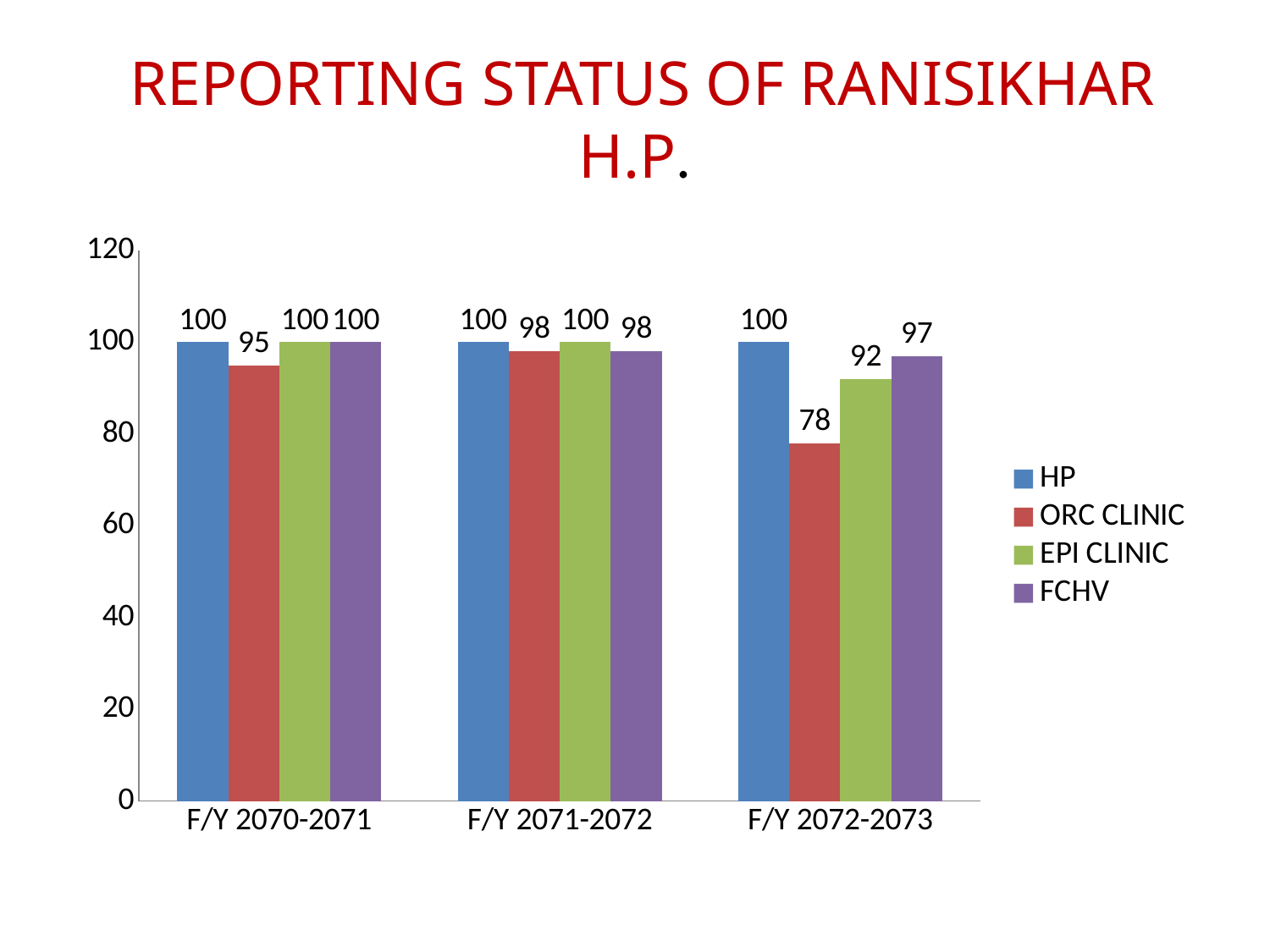
Which is larger in F/Y 2072-2073, EPI CLINIC or FCHV? FCHV What is the value for ORC CLINIC in F/Y 2072-2073? 78 How many fiscal year categories are shown on the x axis? 3 How many series does the legend list? 4 Which series has the lowest value in F/Y 2072-2073? ORC CLINIC What is the value for FCHV in F/Y 2071-2072? 98 What is the value for ORC CLINIC in F/Y 2070-2071? 95 What kind of chart is shown on the slide? Bar chart What is the difference between the HP and ORC CLINIC values in F/Y 2072-2073? 22 What is the difference between the FCHV values in F/Y 2070-2071 and F/Y 2072-2073? 3 What is the value for EPI CLINIC in F/Y 2072-2073? 92